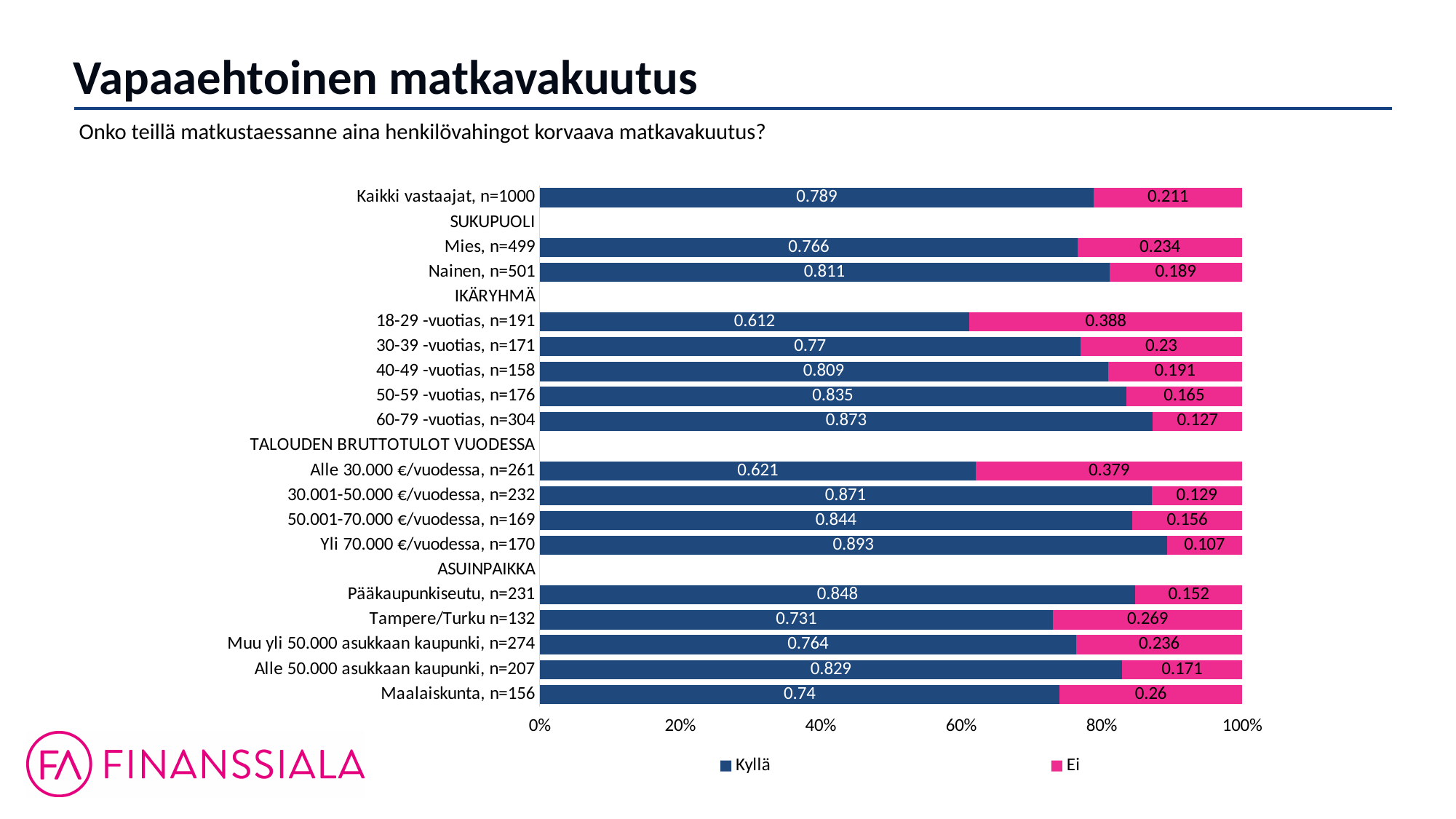
Which category has the lowest Kyllä value? 18-29 -vuotias, n=191 What is the Kyllä value for Kaikki vastaajat, n=1000? 0.789 Do the Kyllä values rise or fall across the age groups from 18-29 -vuotias to 60-79 -vuotias? Rise What is the total of the stacked bar for Maalaiskunta, n=156? 1 What is the Kyllä value for Yli 70.000 €/vuodessa, n=170? 0.893 Which category has the highest Kyllä value? Yli 70.000 €/vuodessa, n=170 What kind of chart is shown on the slide? Stacked bar chart What is the difference between the Kyllä values for Nainen, n=501 and Mies, n=499? 0.045 What is the Ei value for 18-29 -vuotias, n=191? 0.388 How many series does the legend list? 2 Which has a larger Kyllä value, Pääkaupunkiseutu, n=231 or Tampere/Turku n=132? Pääkaupunkiseutu, n=231 Is the Kyllä value for 60-79 -vuotias, n=304 greater or less than 80%? greater